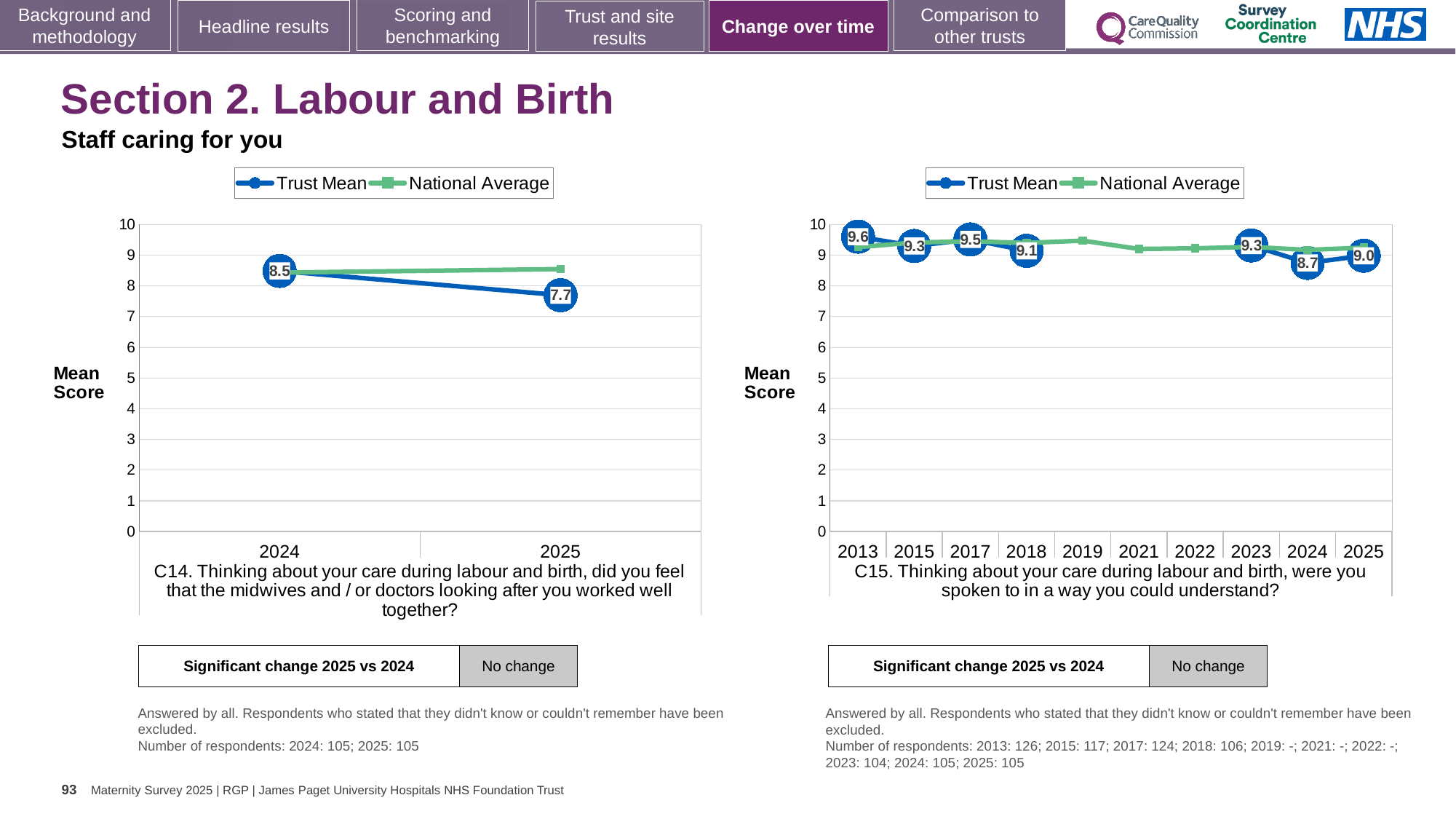
In the C14 chart on the left, does the Trust Mean rise or fall from 2024 to 2025? fall In the C15 chart on the right, which year has the lowest labelled Trust Mean? 2024 In the C14 chart on the left, by how much did the Trust Mean fall from 2024 to 2025? 0.8 In the C14 chart on the left, what is the Trust Mean for 2025? 7.7 How many years are shown on the x axis of the C15 chart on the right? 10 What type of chart is the C15 chart on the right? line chart In the C15 chart on the right, which year has the highest labelled Trust Mean? 2013 In the C15 chart on the right, what is the Trust Mean for 2013? 9.6 How many series does the legend of the C14 chart on the left list? 2 In the C15 chart on the right, what is the difference between the Trust Mean in 2017 and in 2018? 0.4 In the C15 chart on the right, what is the Trust Mean for 2024? 8.7 In the C14 chart on the left, what is the Trust Mean for 2024? 8.5